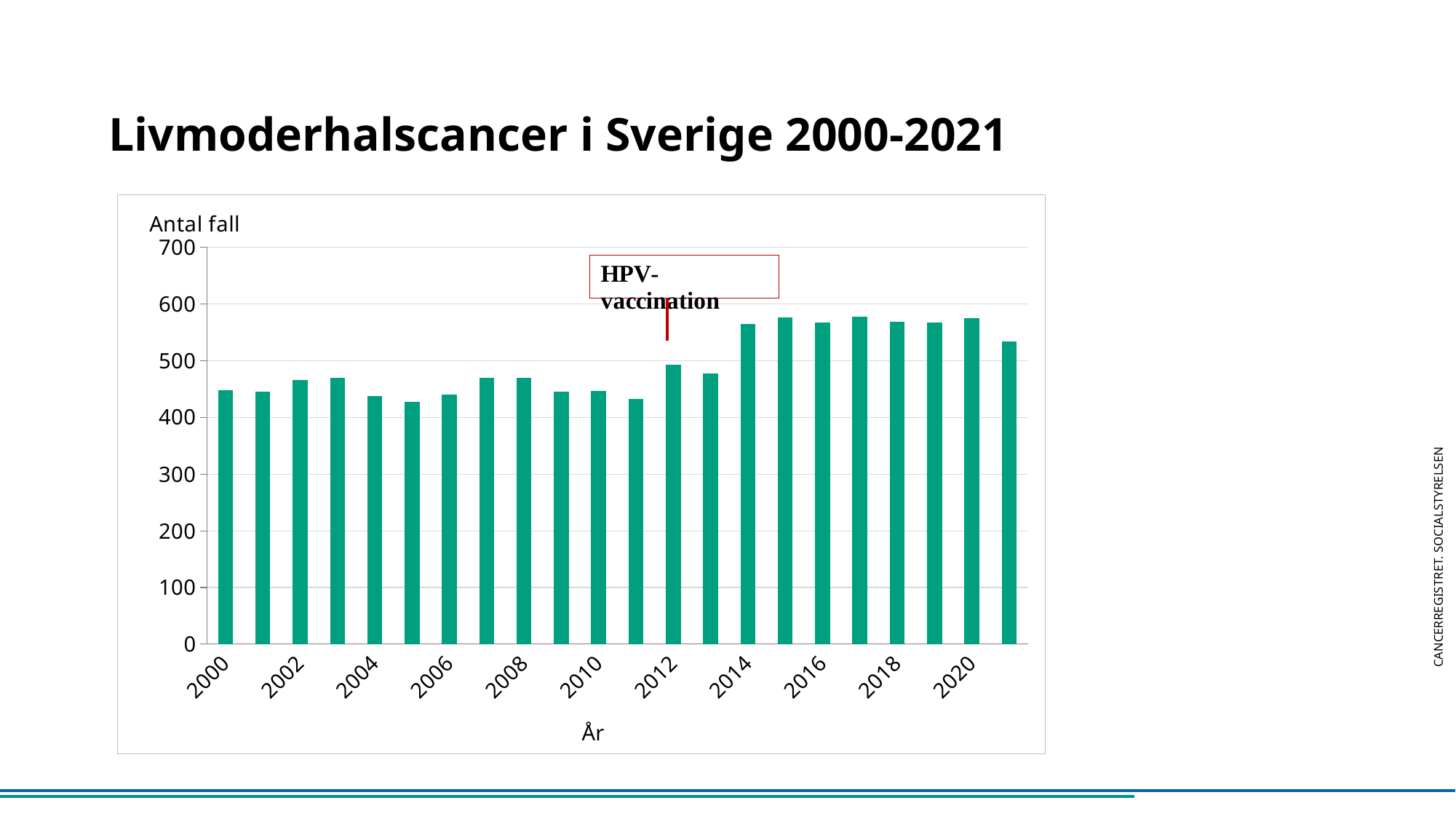
Is the value for 2021 greater or less than 600? less What kind of chart is shown on the slide? bar chart Is the value for 2015 greater or less than 500? greater What is the title of the chart on the slide? Livmoderhalscancer i Sverige 2000-2021 How many bars (years) are plotted in the chart? 22 Is the value for 2017 greater or less than 500? greater Which year has the larger value, 2005 or 2015? 2015 Do the values rise or fall from 2013 to 2015? rise What label is shown on the vertical axis of the chart? Antal fall Which year has the larger value, 2000 or 2021? 2021